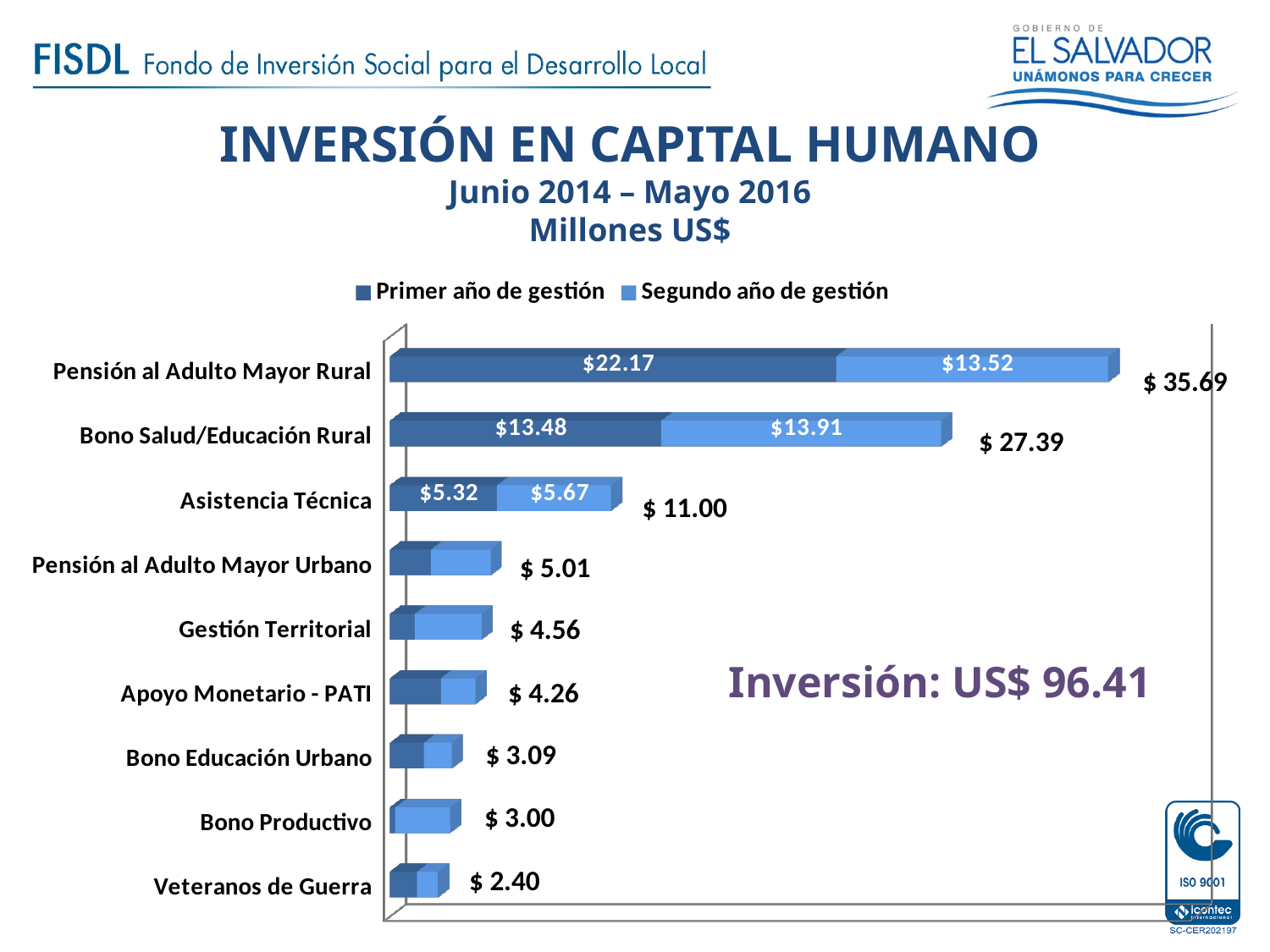
What is the total value shown for Asistencia Técnica? $ 11.00 What is the total value shown for Bono Productivo? $ 3.00 For Asistencia Técnica, how much larger is the Segundo año de gestión value than the Primer año de gestión value? $0.35 What kind of chart is shown on the slide? Stacked bar chart What is the value for Primer año de gestión for Pensión al Adulto Mayor Rural? $22.17 What is the difference between the total for Pensión al Adulto Mayor Rural and the total for Bono Salud/Educación Rural? $ 8.30 Which has a larger total value, Gestión Territorial or Apoyo Monetario - PATI? Gestión Territorial What is the value for Segundo año de gestión for Bono Salud/Educación Rural? $13.91 Which category has the highest total value? Pensión al Adulto Mayor Rural How many series does the legend list? 2 How many categories are shown in the chart? 9 Which category has the lowest total value? Veteranos de Guerra